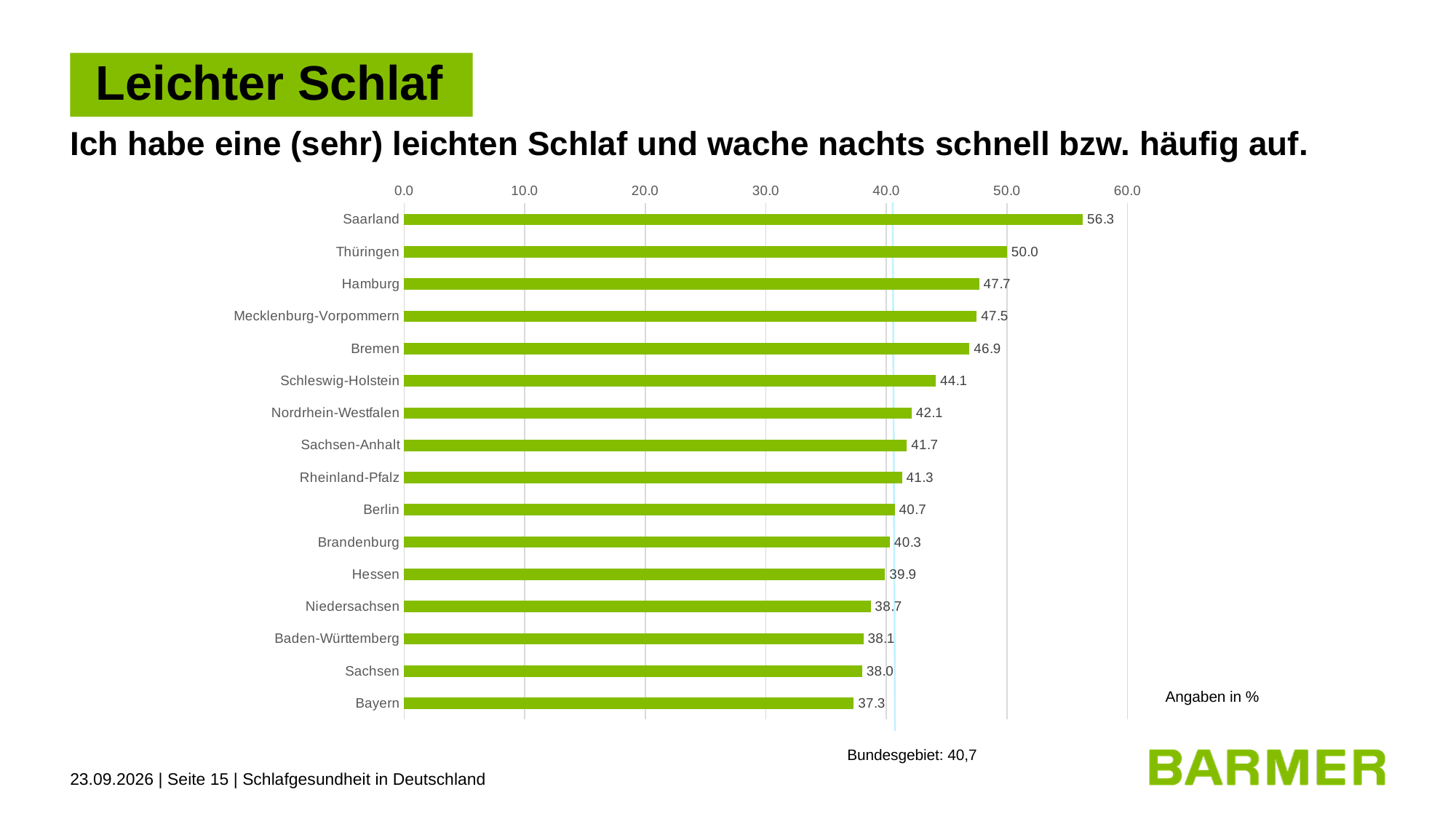
Which federal state has the lowest value? Bayern Is the value for Nordrhein-Westfalen greater or less than 40.0? greater What is the value for Berlin? 40.7 What is the difference between the values for Saarland and Bayern? 19.0 How many federal states are shown in the chart? 16 Which federal state has the highest value? Saarland What is the value for Hamburg? 47.7 What kind of chart is shown on the slide? Bar chart What is the difference between the values for Thüringen and Hessen? 10.1 What value is given for Bundesgebiet below the chart? 40,7 What is the value for Saarland? 56.3 Which has a larger value, Bremen or Schleswig-Holstein? Bremen